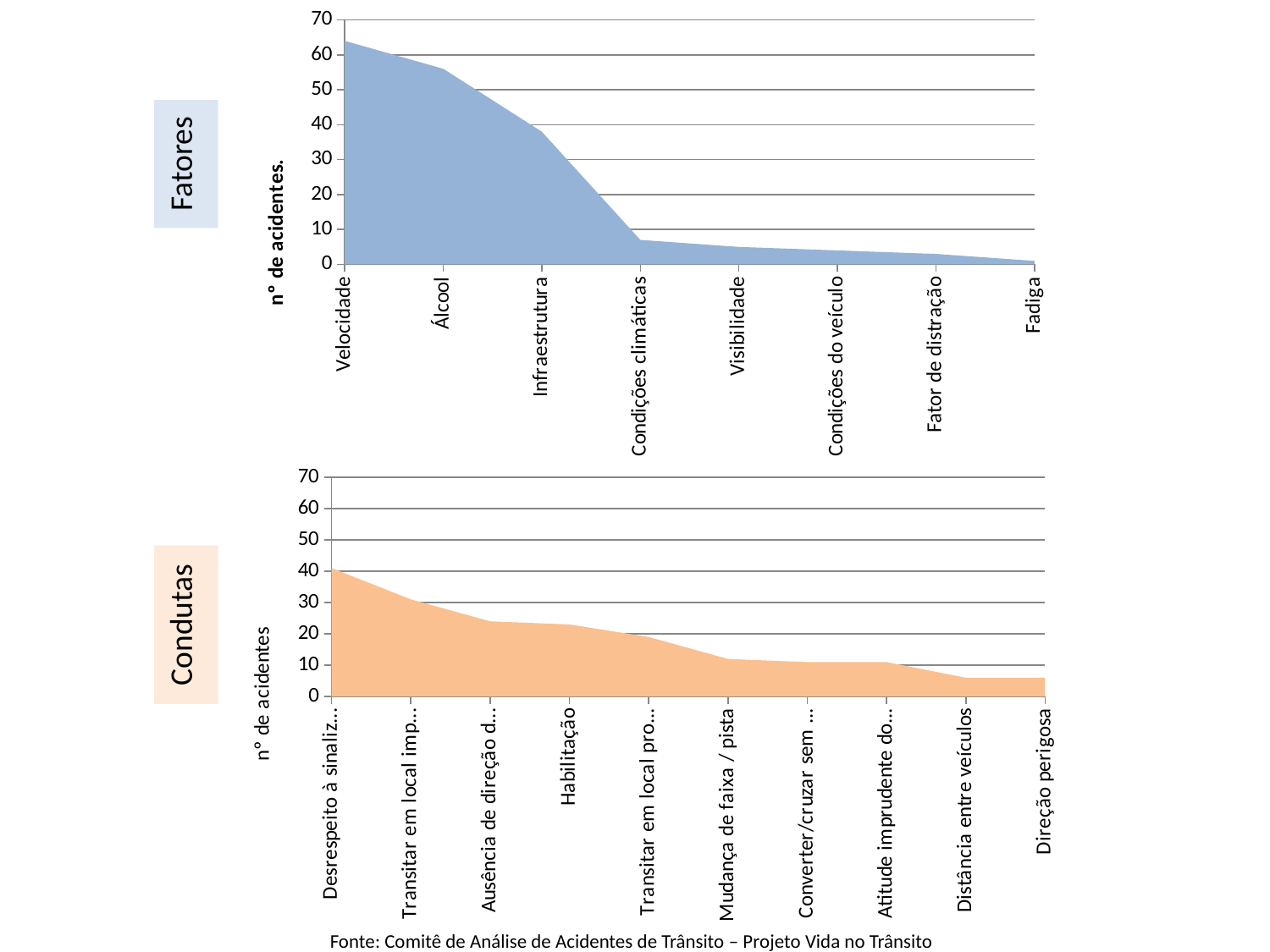
In the bottom chart (Condutas), is the value for Distância entre veículos greater or less than 10? less How many categories are shown on the x axis of the top chart (Fatores)? 8 In the bottom chart (Condutas), is the value for Habilitação greater or less than 20? greater What kind of chart is the top chart (Fatores)? area chart In the bottom chart (Condutas), which is larger, the value for Habilitação or the value for Direção perigosa? Habilitação In the top chart (Fatores), is the value for Velocidade greater or less than 60? greater In the top chart (Fatores), which category has the lowest number of accidents? Fadiga In the bottom chart (Condutas), which category has the highest number of accidents? Desrespeito à sinaliz... In the top chart (Fatores), which category has the highest number of accidents? Velocidade In the top chart (Fatores), do the values rise or fall from left to right along the x axis? fall